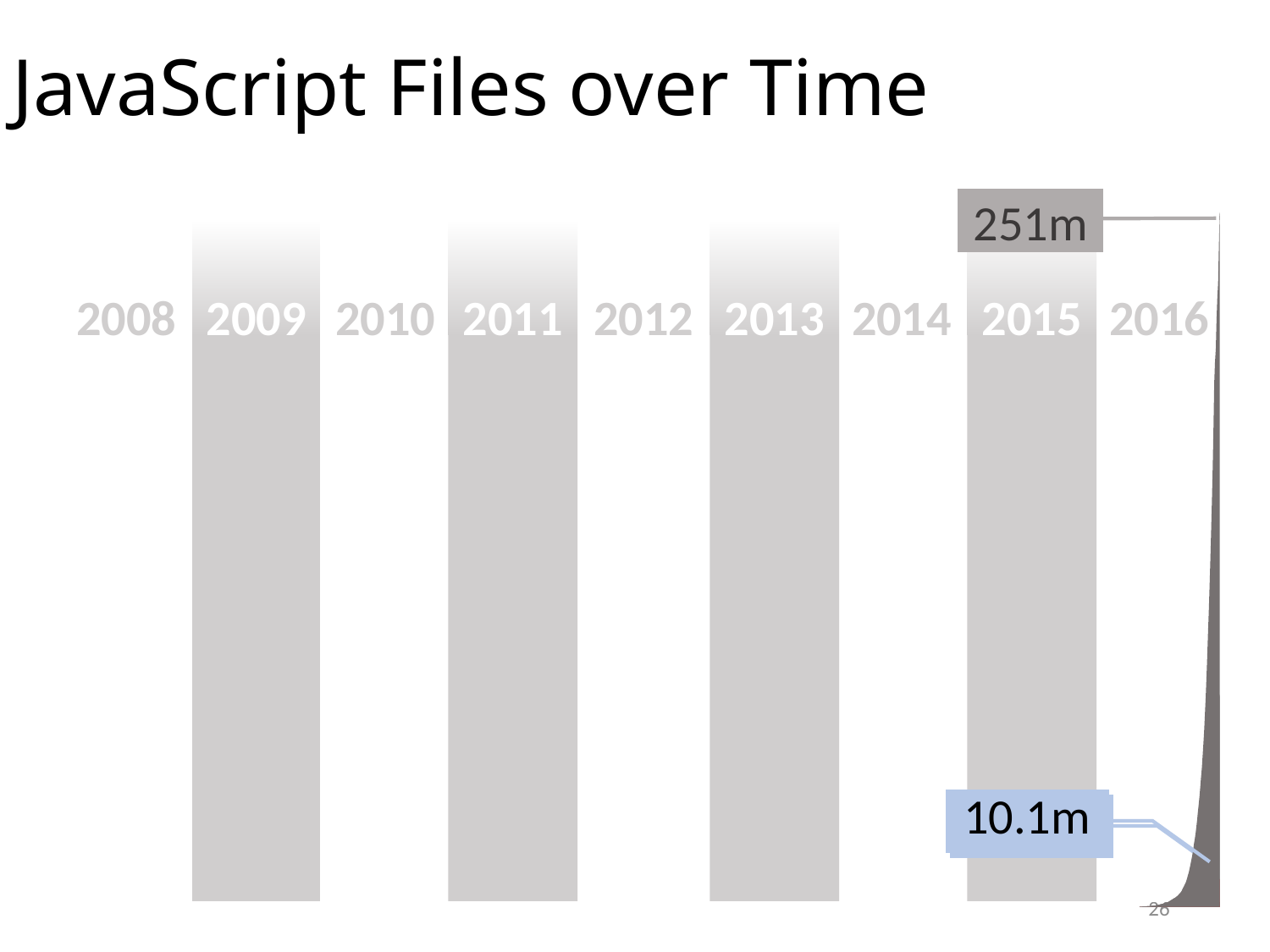
What is the value labelled at the peak of the chart in 2016? 251m Which year has the larger value, 2008 or 2016? 2016 What is the first year shown on the x axis? 2008 What kind of chart is shown on the slide? area chart What is the difference between the two labelled values, 251m and 10.1m? 240.9m What is the title of the chart? JavaScript Files over Time What is the smaller value labelled on the chart? 10.1m How many years are labelled along the x axis? 9 In which year does the number of JavaScript files reach its highest value? 2016 Do the values rise or fall from 2008 to 2016? rise Which year has the lowest value on the chart? 2008